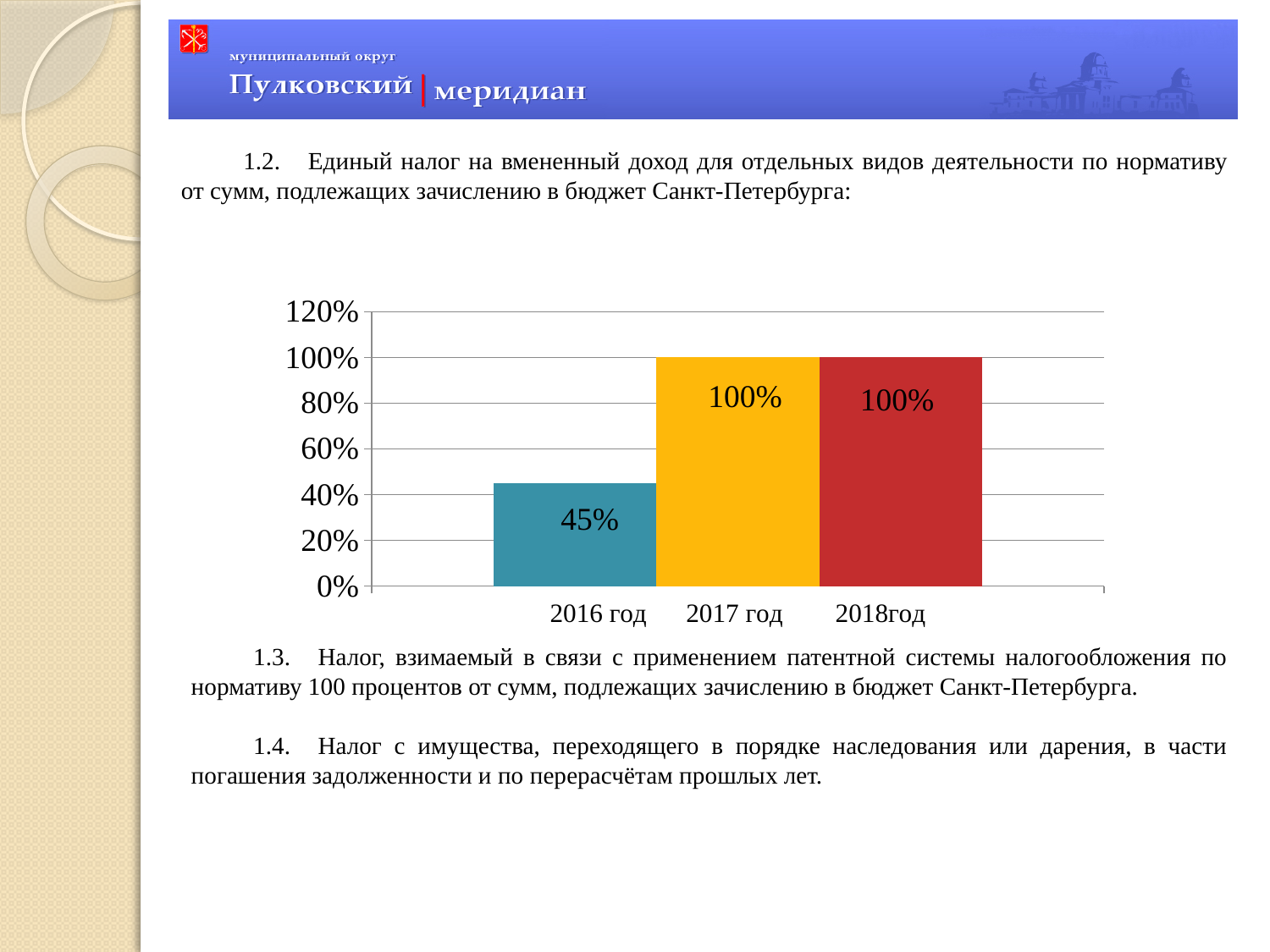
What kind of chart is shown on the slide? bar chart Is the value for 2017 год greater or less than 80%? greater Is the value for 2016 год greater or less than 60%? less Does the value rise or fall from 2016 год to 2017 год? rise What colour is the bar for 2018год? red What is the value for 2018год? 100% Which is larger, the value for 2016 год or the value for 2018год? 2018год What is the value for 2016 год? 45% Which year has the lowest value? 2016 год What is the value for 2017 год? 100% What is the difference between the values for 2017 год and 2016 год? 55% How many years are shown on the chart? 3